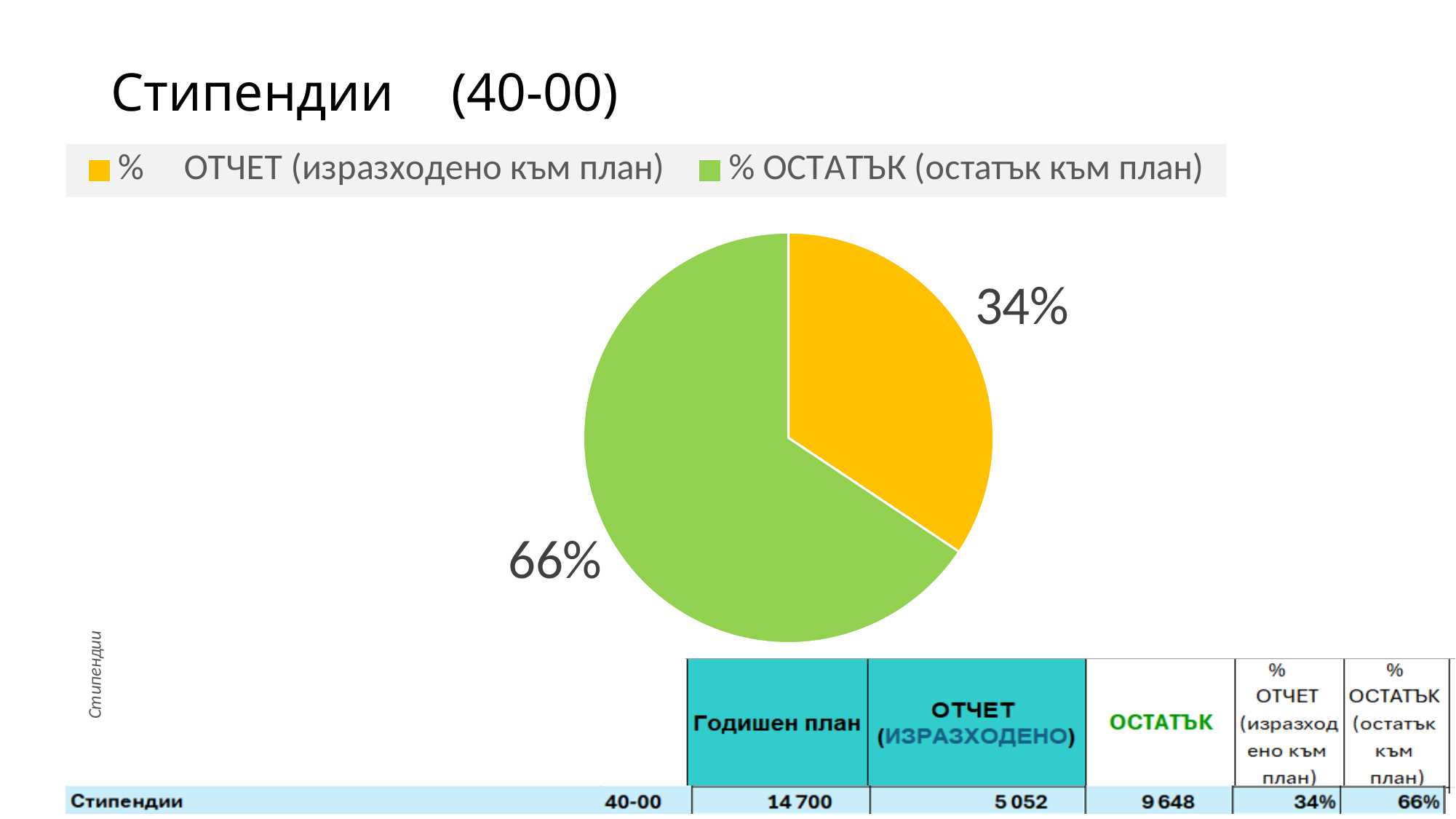
What is the total of the two slice percentages shown on the pie chart? 100% How many slices does the pie chart have? 2 Which slice of the pie is the largest? % ОСТАТЪК (остатък към план) Which is larger: the "% ОТЧЕТ" slice or the "% ОСТАТЪК" slice? % ОСТАТЪК What is the difference in percentage points between the "% ОСТАТЪК" slice and the "% ОТЧЕТ" slice? 32 What colour is the "% ОСТАТЪК (остатък към план)" slice? green What share of the pie does the "% ОТЧЕТ (изразходено към план)" slice represent? 34% Which slice of the pie is the smallest? % ОТЧЕТ (изразходено към план) What share of the pie does the "% ОСТАТЪК (остатък към план)" slice represent? 66% What colour is the "% ОТЧЕТ (изразходено към план)" slice? orange What kind of chart is shown on the slide? pie chart How many entries does the chart legend list? 2